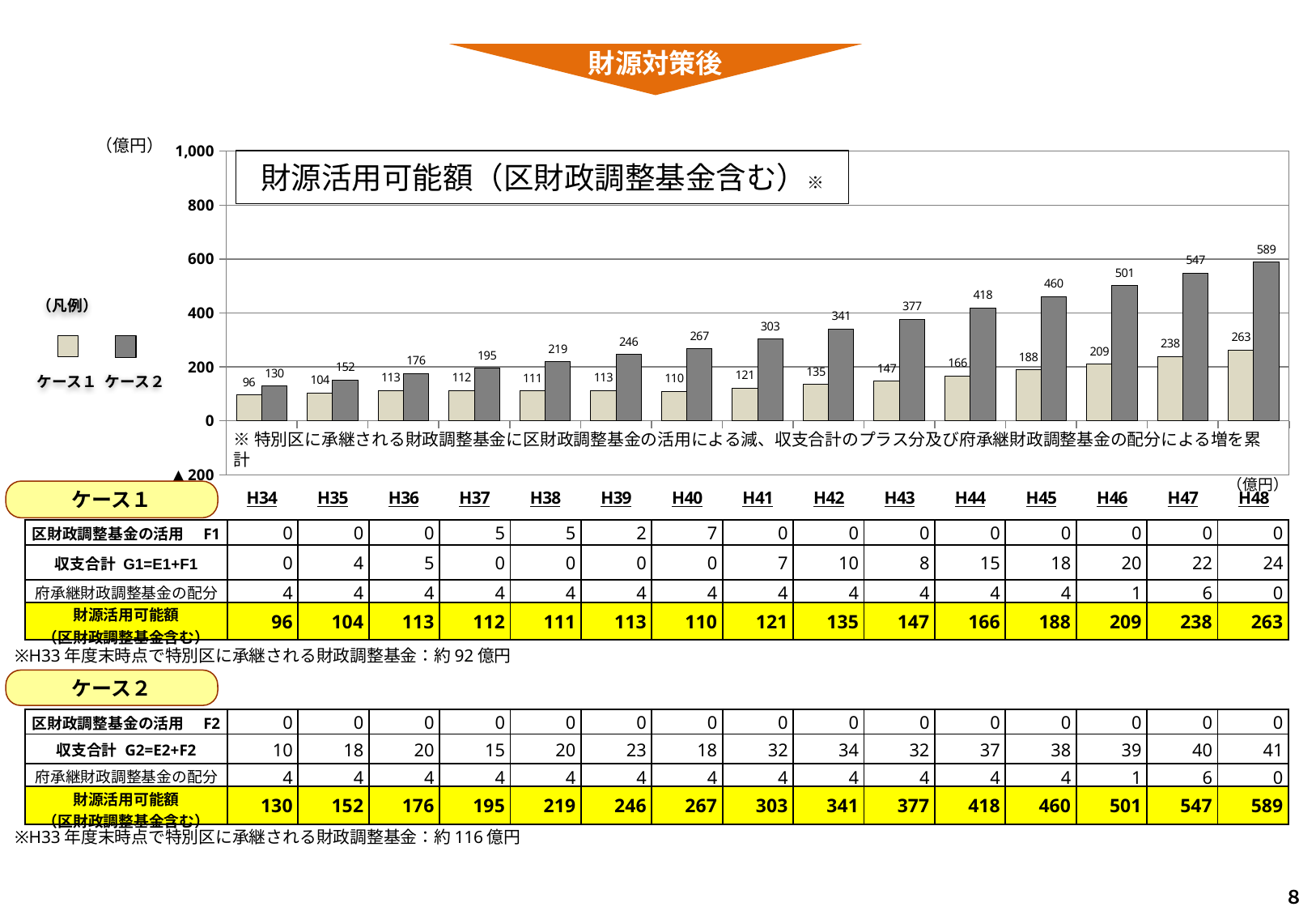
What kind of chart is shown on the slide? bar chart In which year is the ケース1 value lowest? H34 What is the value for ケース2 in H41? 303 How many series does the legend list for the chart? 2 What is the value for ケース2 in H48? 589 What is the difference between the ケース2 and ケース1 values in H48? 326 In which year is the ケース2 value highest? H48 Which is larger in H40: the ケース1 value or the ケース2 value? ケース2 How many categories (years) are plotted along the x axis of the chart? 15 What is the value for ケース1 in H34? 96 Do the ケース2 values rise or fall from H34 to H48? rise What is the title of the chart? 財源活用可能額（区財政調整基金含む）